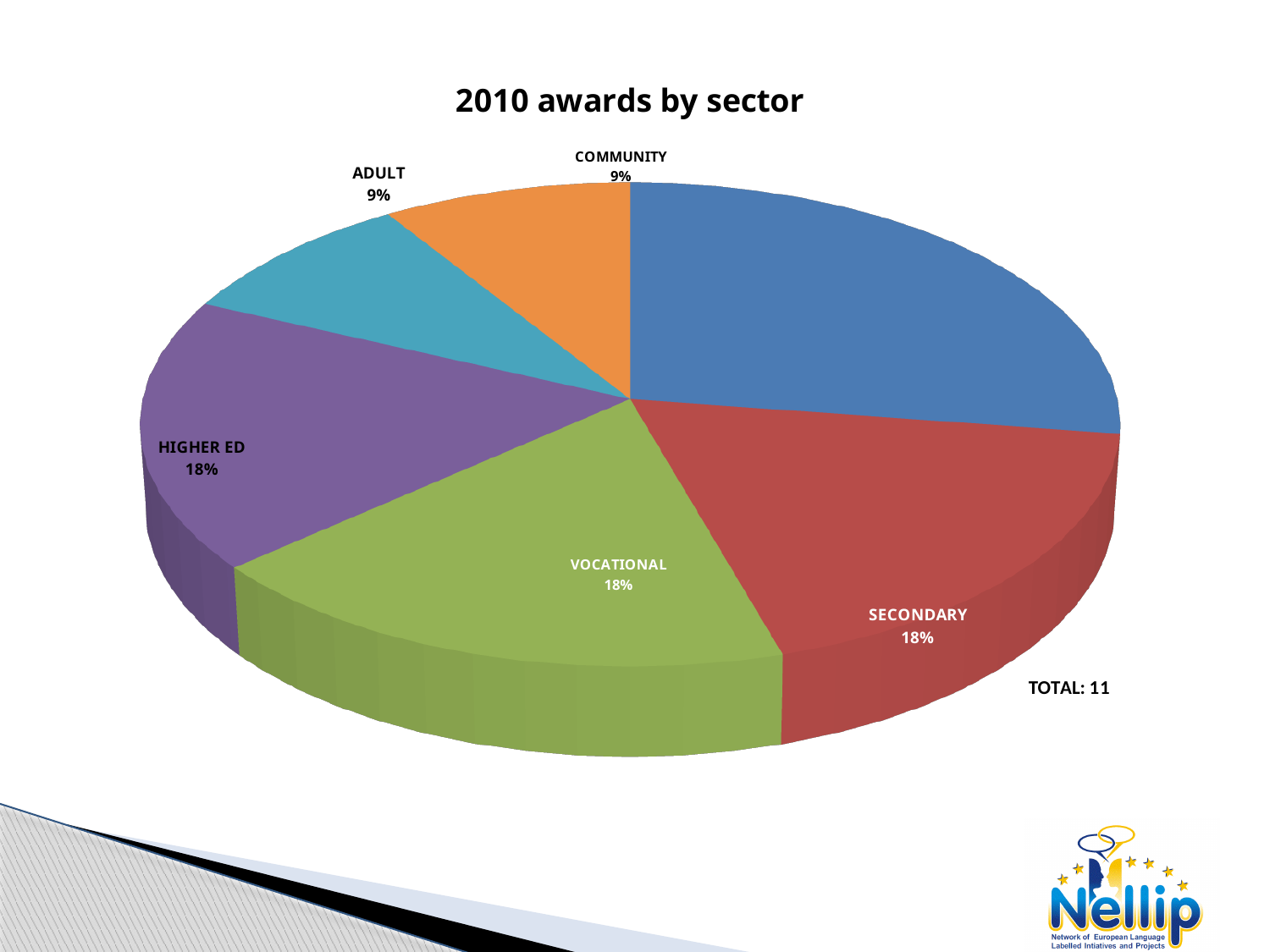
What total number of awards is stated on the slide? 11 What percentage of 2010 awards went to the VOCATIONAL sector? 18% How many slices does the pie chart have? 6 Is the share for VOCATIONAL greater or less than 10%? greater What is the title of the pie chart? 2010 awards by sector What percentage of 2010 awards went to the SECONDARY sector? 18% Which has the larger share, SECONDARY or ADULT? SECONDARY What share of the pie does the COMMUNITY sector have? 9% What share of the pie does the ADULT sector have? 9% What kind of chart is shown on the slide? pie chart What is the difference in percentage points between the HIGHER ED share and the COMMUNITY share? 9 What percentage of 2010 awards went to the HIGHER ED sector? 18%